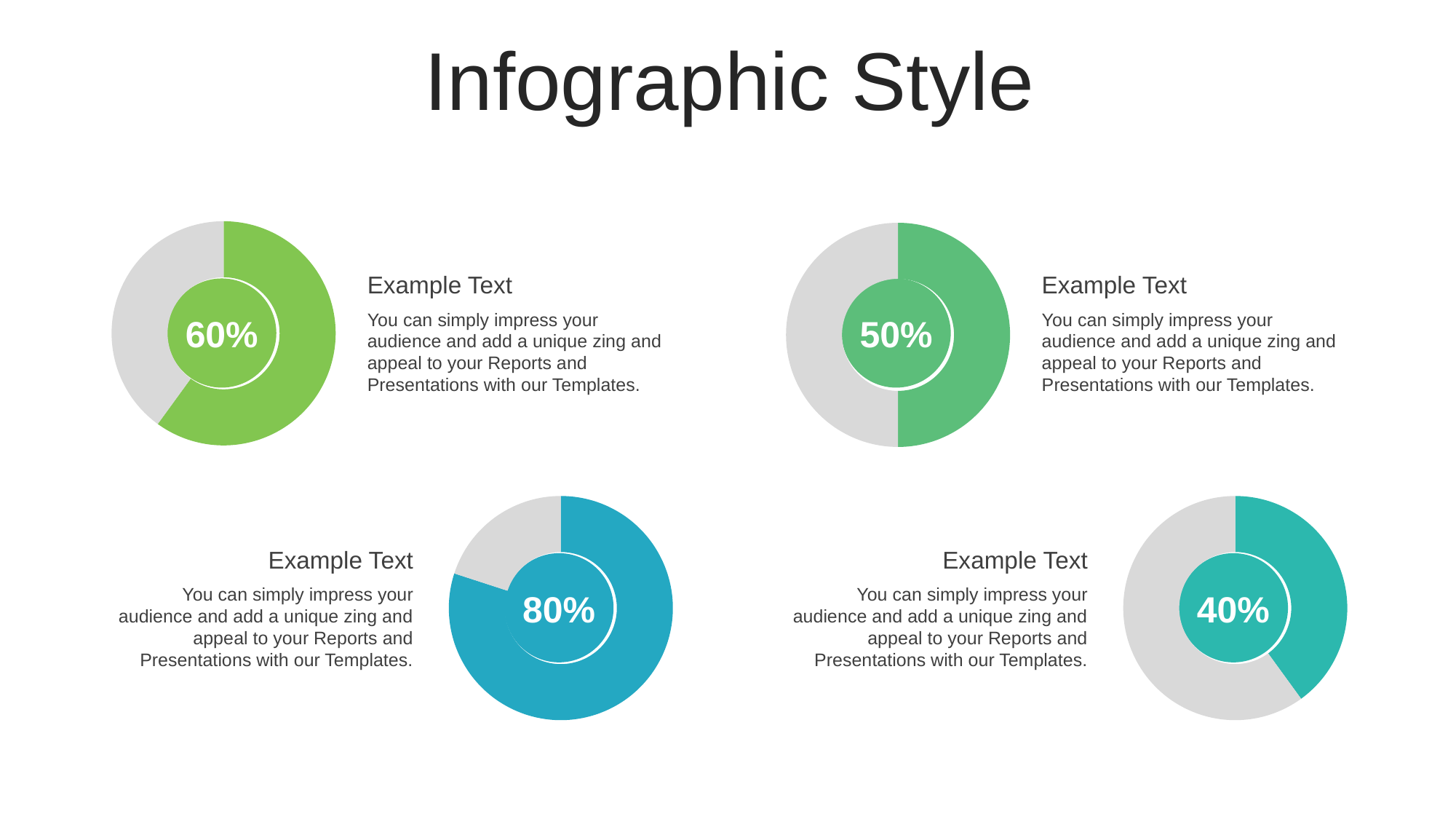
What kind of chart is used on this slide? Pie chart (donut) Which of the four charts shows the lowest percentage? The bottom-right chart (40%) What percentage is shown in the bottom-right chart? 40% What percentage is shown in the top-right chart? 50% What is the difference between the percentage in the bottom-left chart and the percentage in the bottom-right chart? 40% What percentage is shown in the bottom-left chart? 80% In the top-right chart, what share of the circle is filled with the green colour? 50% What percentage is shown in the top-left chart? 60% Which is larger, the percentage in the top-left chart or the percentage in the top-right chart? The top-left chart (60%) Which of the four charts shows the highest percentage? The bottom-left chart (80%) How many charts are on the slide? 4 What colour is the filled portion of the bottom-left chart? Blue